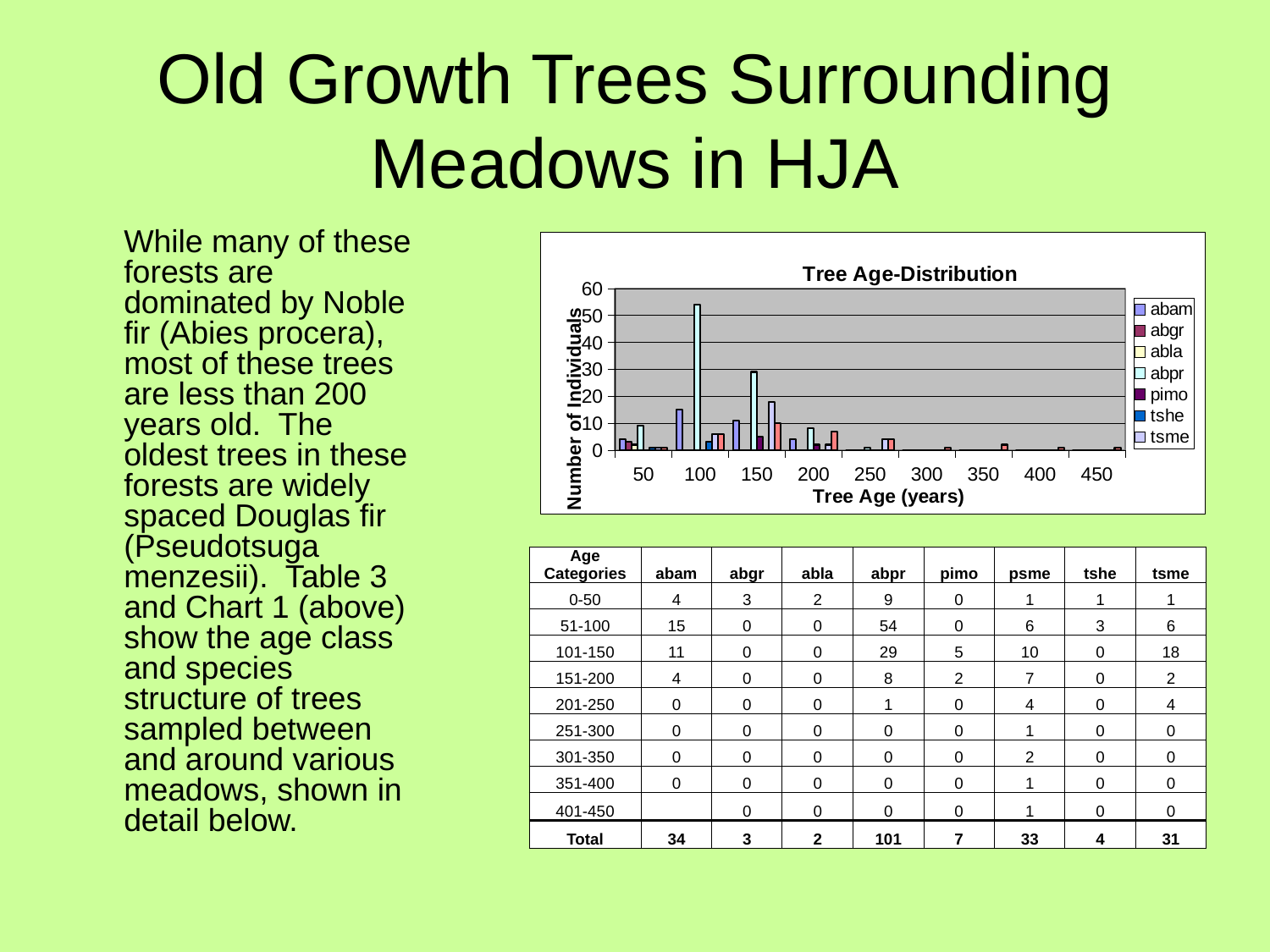
What is the title of the chart? Tree Age-Distribution How many series does the chart's legend list? 7 According to the table, how many abpr individuals are in the 51-100 age category? 54 According to the table, what is the total number of tsme individuals? 31 What is the label of the y axis of the chart? Number of Individuals What type of chart is shown on the slide? bar chart Is the abpr bar at tree age 150 greater or less than 20? greater Which is larger, the abpr bar at age 100 or the abpr bar at age 150? abpr at age 100 How many tick labels are shown on the x axis of the chart? 9 Is the abam bar at tree age 100 greater or less than 20? less Which species has the tallest bar in the chart? abpr Is the tallest bar in the chart (abpr at age 100) greater or less than 50? greater